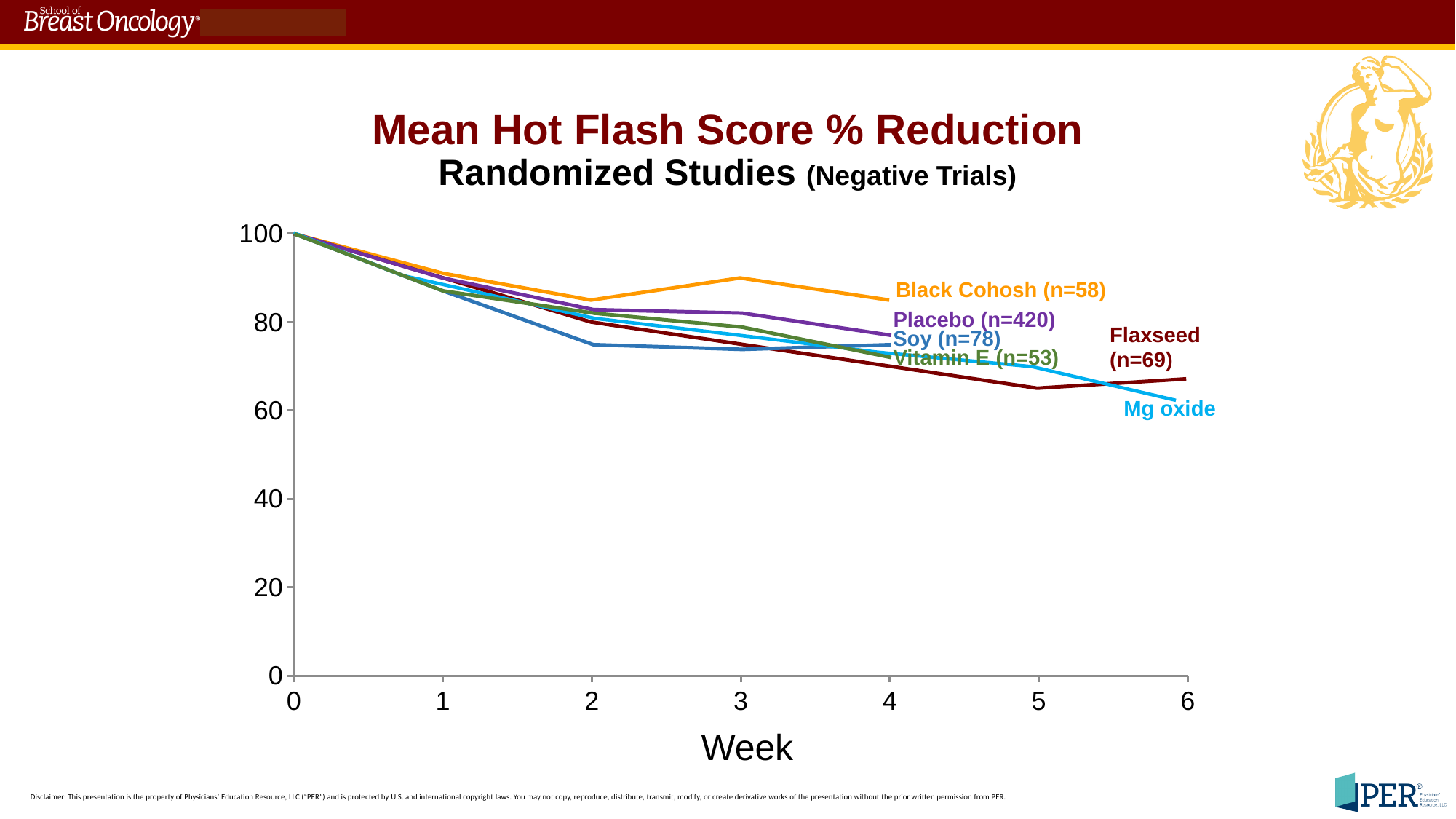
At week 4, which is larger: the value for Black Cohosh (n=58) or the value for Flaxseed (n=69)? Black Cohosh (n=58) Do the values for Placebo (n=420) generally rise or fall from week 0 to week 4? fall Is the value for Flaxseed (n=69) at week 5 greater or less than 80? less Is the value for Mg oxide at week 6 greater or less than 80? less What is the label of the x axis? Week What kind of chart is shown on the slide? line chart Is the value for Soy (n=78) at week 2 greater or less than 80? less What value do all the series start at in week 0? 100 Which series has the highest value at week 4? Black Cohosh (n=58) How many treatment series (lines) are labeled on the chart? 6 What is the main title of the chart? Mean Hot Flash Score % Reduction